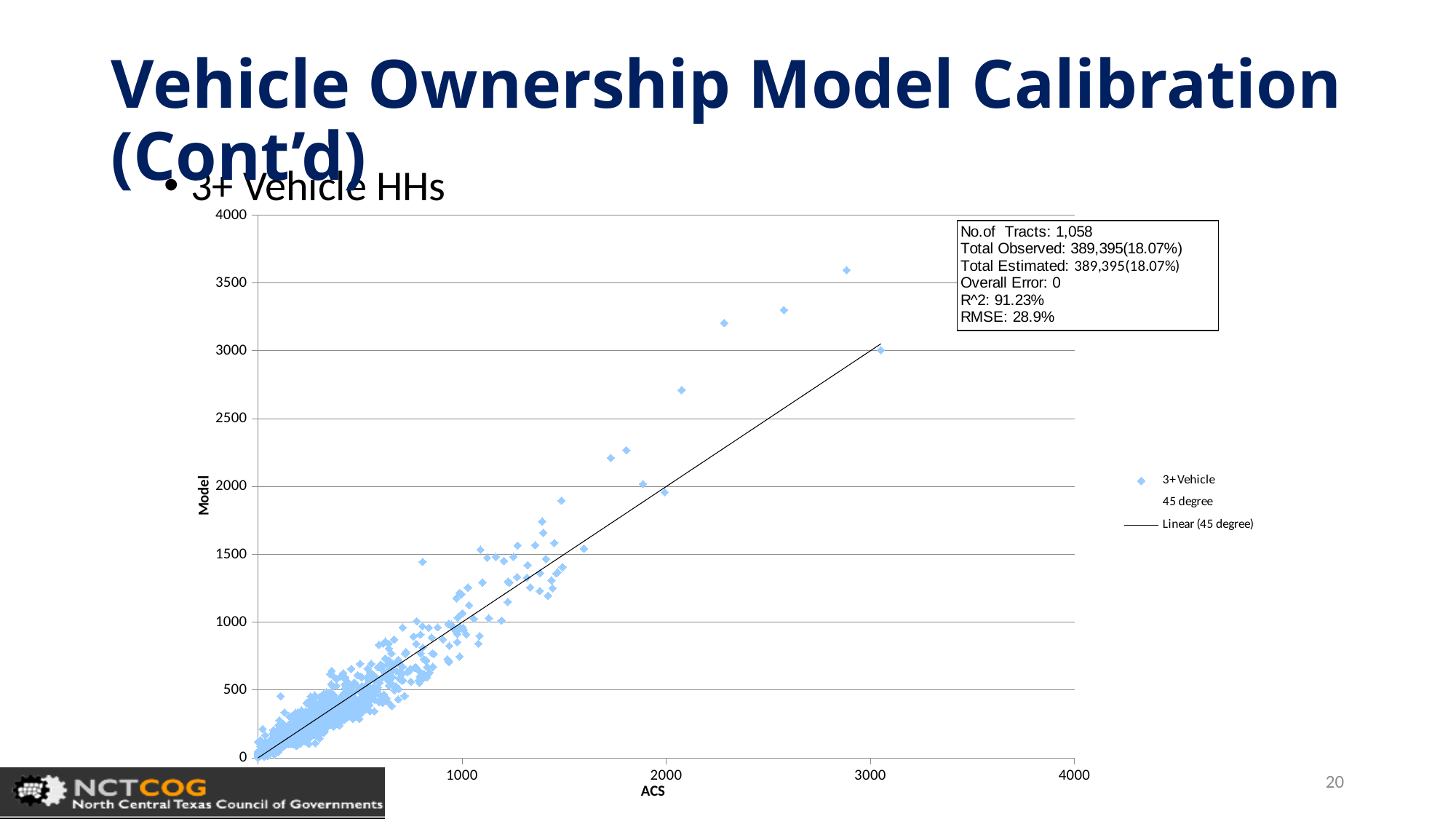
Is the Model value of the point with the largest ACS value greater or less than 3500? less What is the title of the horizontal axis of the chart? ACS According to the text box on the chart, what is the number of tracts? 1,058 Is the Model value of the highest plotted point greater or less than 3500? greater What kind of chart is shown on the slide? Scatter chart According to the text box on the chart, what is the Overall Error? 0 According to the text box on the chart, what is the RMSE? 28.9% Do the plotted Model values generally rise or fall as the ACS value increases along the x axis? Rise According to the text box on the chart, what is the R^2 value? 91.23% How many entries does the chart's legend list? 3 According to the text box on the chart, what is the Total Observed value? 389,395(18.07%) What is the title of the vertical axis of the chart? Model